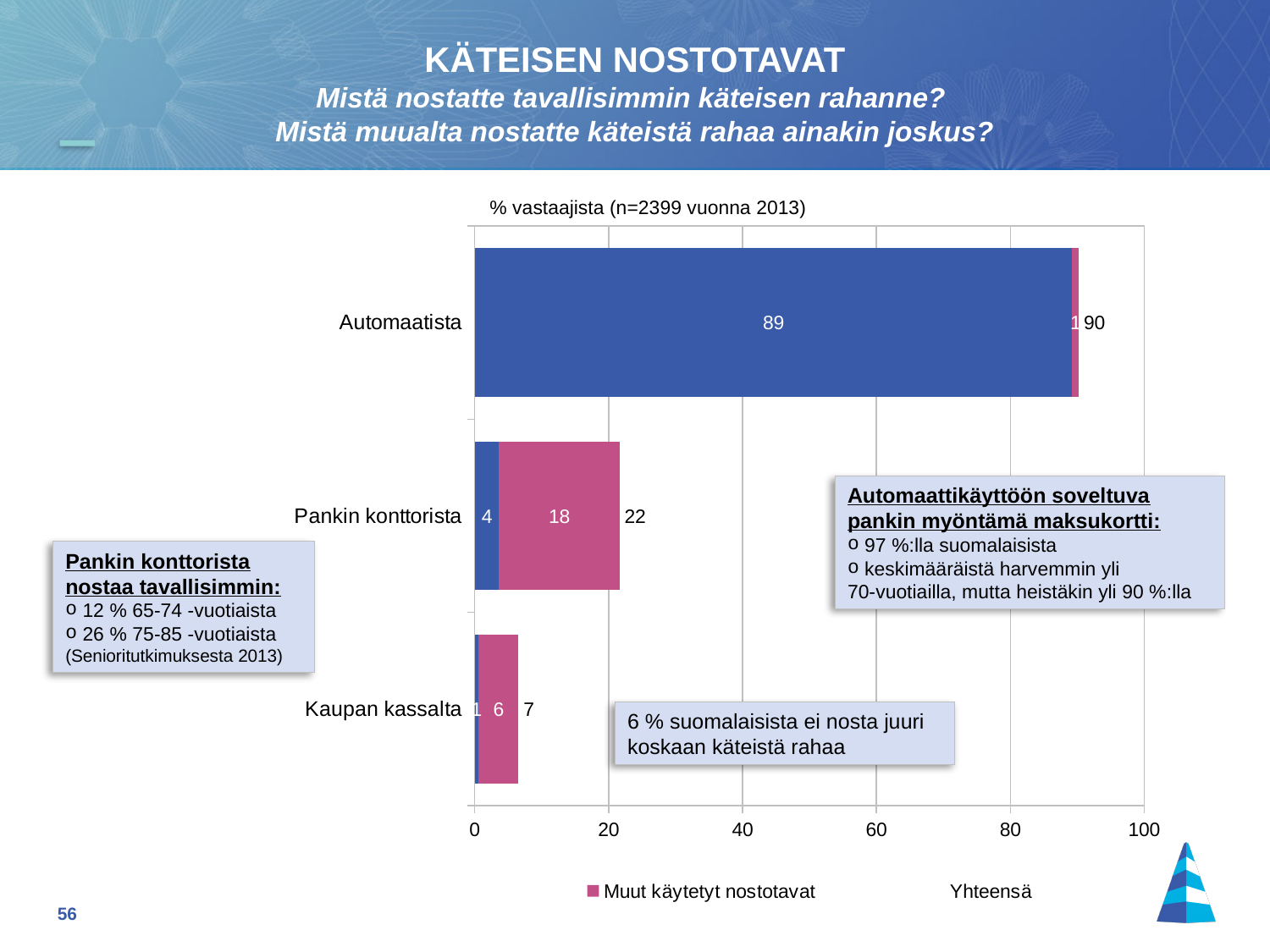
What is the value of the blue segment for Automaatista? 89 How many categories are plotted on the chart? 3 What text appears above the chart as its title? % vastaajista (n=2399 vuonna 2013) Which has the larger Muut käytetyt nostotavat value, Pankin konttorista or Kaupan kassalta? Pankin konttorista Is the Yhteensä value for Automaatista greater or less than 80? greater What is the Yhteensä value for Automaatista? 90 Which category has the highest Yhteensä value? Automaatista What is the Muut käytetyt nostotavat value for Pankin konttorista? 18 What is the Yhteensä value for Kaupan kassalta? 7 What is the difference between the Yhteensä values for Automaatista and Pankin konttorista? 68 Which category has the lowest Yhteensä value? Kaupan kassalta What kind of chart is shown on the slide? bar chart